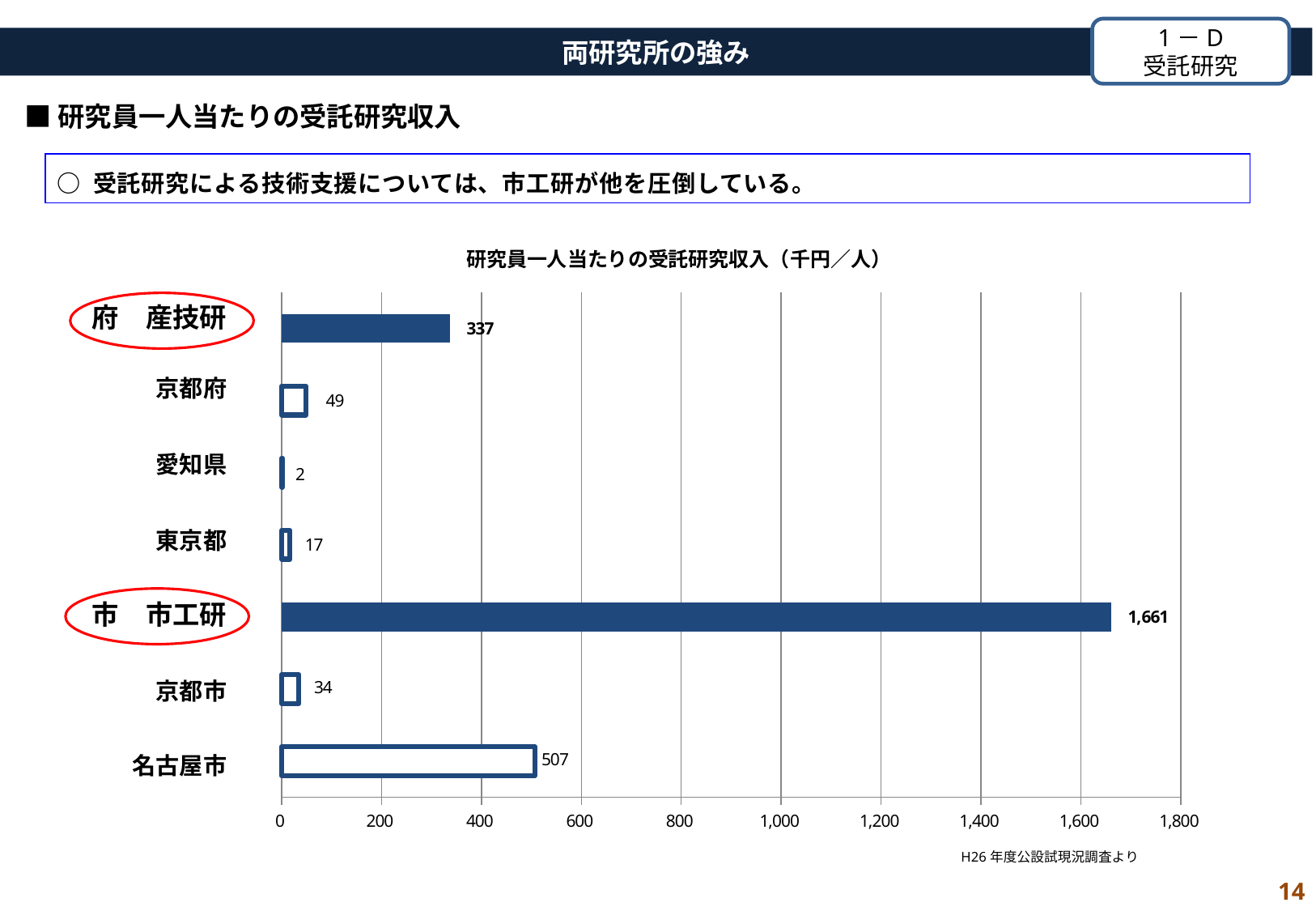
What is the value for 市工研? 1,661 Which category has the lowest value? 愛知県 What is the title of the chart? 研究員一人当たりの受託研究収入（千円／人） What is the difference between the values for 市工研 and 名古屋市? 1,154 How many categories are shown in the chart? 7 What is the value for 京都府? 49 What is the value for 名古屋市? 507 Which is larger, the value for 京都府 or the value for 京都市? 京都府 Which category has the highest value? 市工研 Is the value for 市工研 greater or less than 1,600? greater What is the value for 府 産技研? 337 What kind of chart is shown? Bar chart